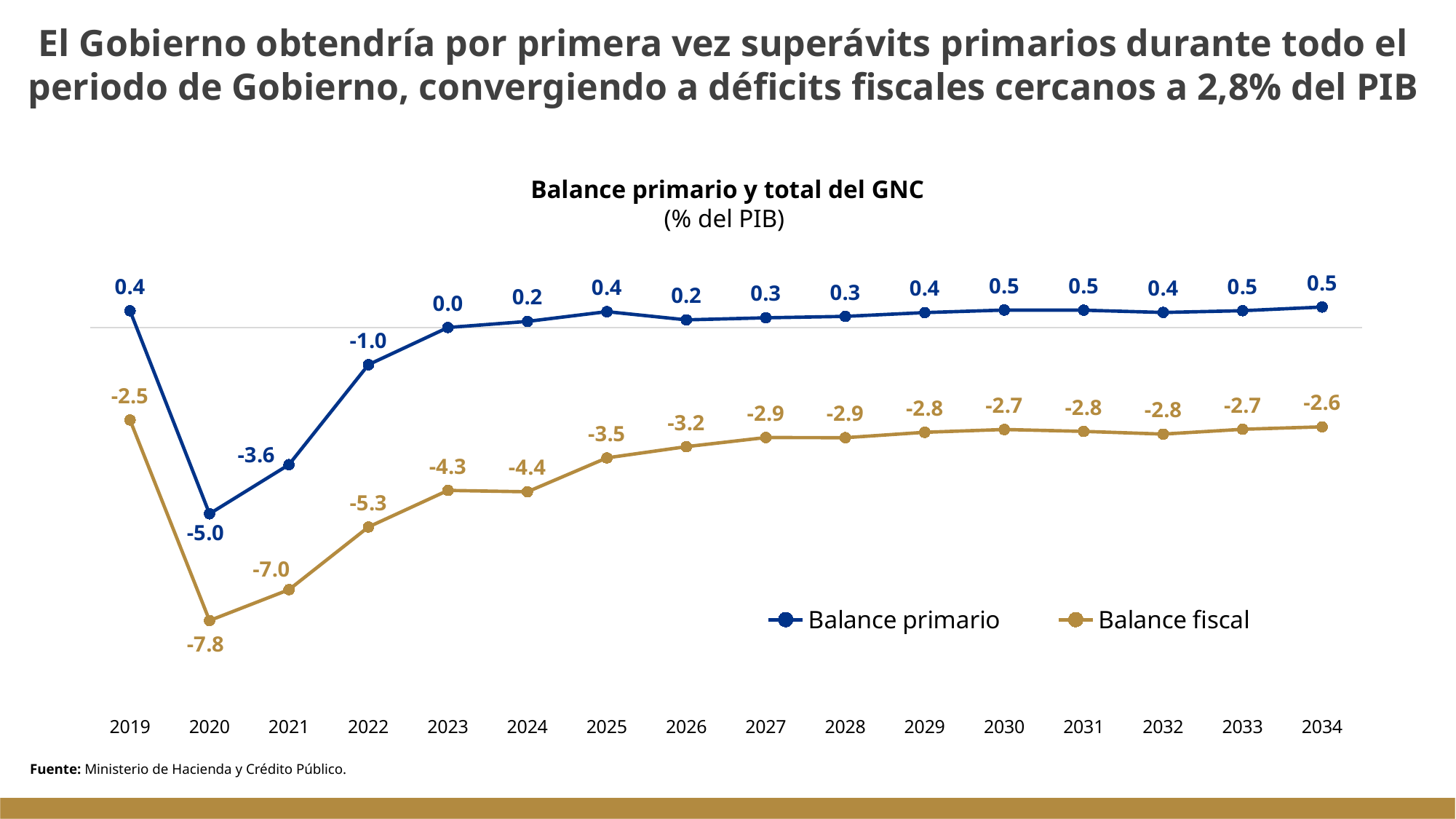
What is the title of the chart? Balance primario y total del GNC How many years are shown on the x axis? 16 What is the difference between Balance primario and Balance fiscal in 2019? 2.9 What is the value of Balance primario in 2020? -5.0 Which is larger in 2021: Balance primario or Balance fiscal? Balance primario In which year is Balance primario lowest? 2020 What kind of chart is shown? Line chart What is the value of Balance fiscal in 2034? -2.6 In which year is Balance fiscal lowest? 2020 What is the value of Balance fiscal in 2022? -5.3 Does Balance fiscal rise or fall from 2020 to 2025? Rise How many series does the legend list? 2